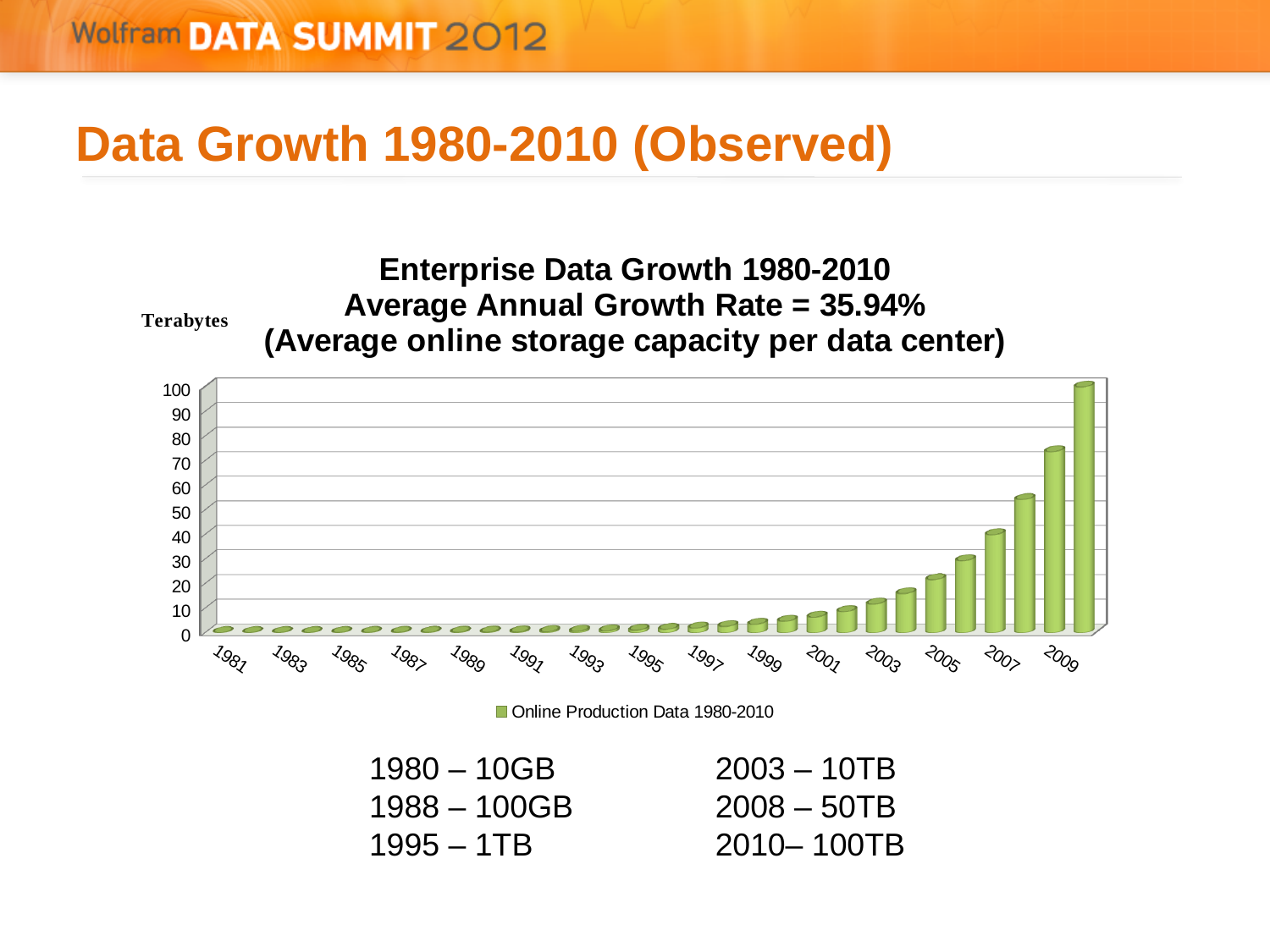
Do the bar values generally rise or fall from left to right along the x axis? rise According to the slide, what was the average online storage capacity per data center in 2003? 10TB Which year has the tallest bar in the chart? 2010 According to the slide, what was the average online storage capacity per data center in 1995? 1TB What type of chart is shown on the slide? bar chart What average annual growth rate is stated in the chart title? 35.94% According to the slide, what was the average online storage capacity per data center in 2010? 100TB Is the value for 2009 greater or less than 60? greater Is the value for 2001 greater or less than 10? less What unit is shown on the vertical axis label of the chart? Terabytes What is the name of the series in the chart legend? Online Production Data 1980-2010 How many series does the chart legend list? 1